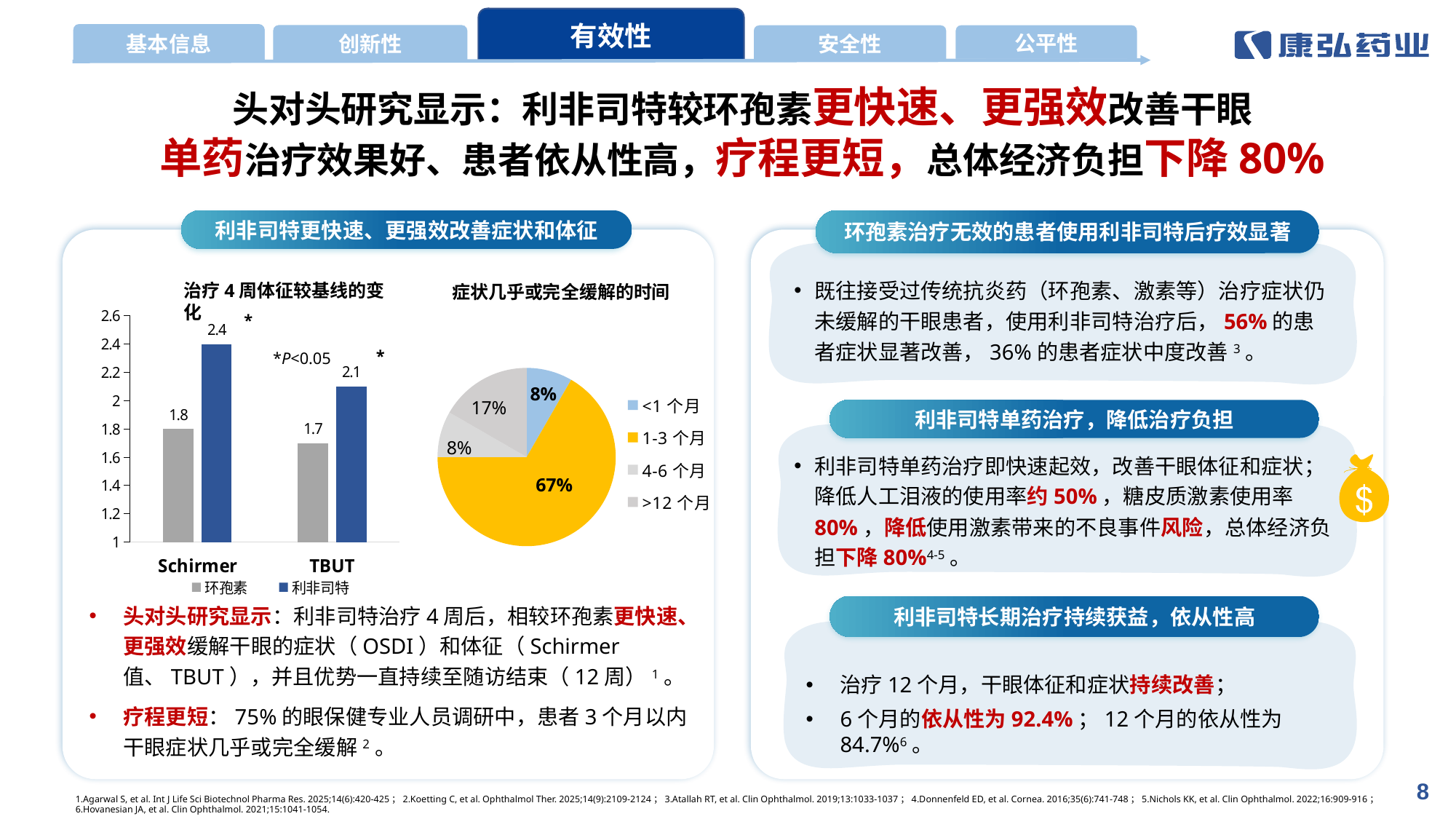
In the bar chart titled 治疗 4 周体征较基线的变化, what is the value for 环孢素 in the TBUT category? 1.7 In the bar chart titled 治疗 4 周体征较基线的变化, which bar has the highest value? 利非司特 in Schirmer (2.4) In the bar chart titled 治疗 4 周体征较基线的变化, what is the value for 环孢素 in the Schirmer category? 1.8 In the pie chart titled 症状几乎或完全缓解的时间, how many categories does the legend list? 4 In the pie chart titled 症状几乎或完全缓解的时间, what share does the <1 个月 slice have? 8% In the bar chart titled 治疗 4 周体征较基线的变化, which series has the higher value in the TBUT category? 利非司特 In the pie chart titled 症状几乎或完全缓解的时间, what share does the 1-3 个月 slice have? 67% In the bar chart titled 治疗 4 周体征较基线的变化, how many series does the legend list? 2 In the pie chart titled 症状几乎或完全缓解的时间, which category has the largest slice? 1-3 个月 In the bar chart titled 治疗 4 周体征较基线的变化, what is the value for 利非司特 in the Schirmer category? 2.4 What kind of chart is the one titled 治疗 4 周体征较基线的变化? Bar chart In the bar chart titled 治疗 4 周体征较基线的变化, what is the difference between 利非司特 and 环孢素 in the Schirmer category? 0.6